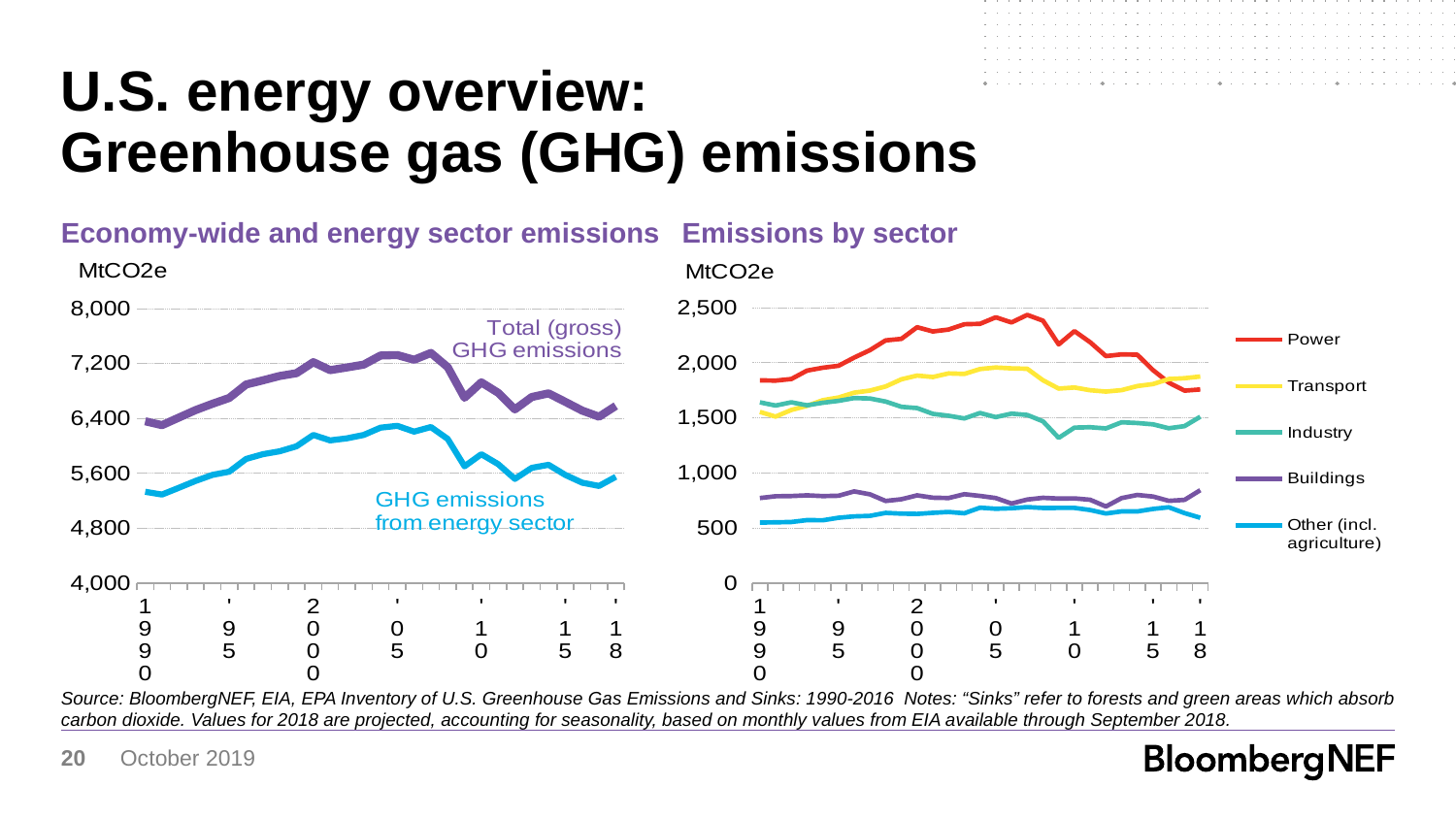
What unit is shown on the y axis of both charts? MtCO2e In the 'Emissions by sector' chart, which is higher in 1990, Power or Transport? Power In the 'Emissions by sector' chart, is the value for Power in 2018 greater or less than 2,000? less In the 'Economy-wide and energy sector emissions' chart, do Total (gross) GHG emissions rise or fall between 1990 and 2005? rise How many series does the legend of the 'Emissions by sector' chart list? 5 In the 'Emissions by sector' chart, which sector has the lowest emissions in 1990? Other (incl. agriculture) In the 'Emissions by sector' chart, is the peak value of the Power series greater or less than 2,000? greater In the 'Emissions by sector' chart, is the value for Buildings in 1990 greater or less than 1,000? less In the 'Emissions by sector' chart, which is higher in 2018, Power or Transport? Transport How many series are plotted in the 'Economy-wide and energy sector emissions' chart? 2 What kind of chart is the 'Economy-wide and energy sector emissions' chart on the left? Line chart